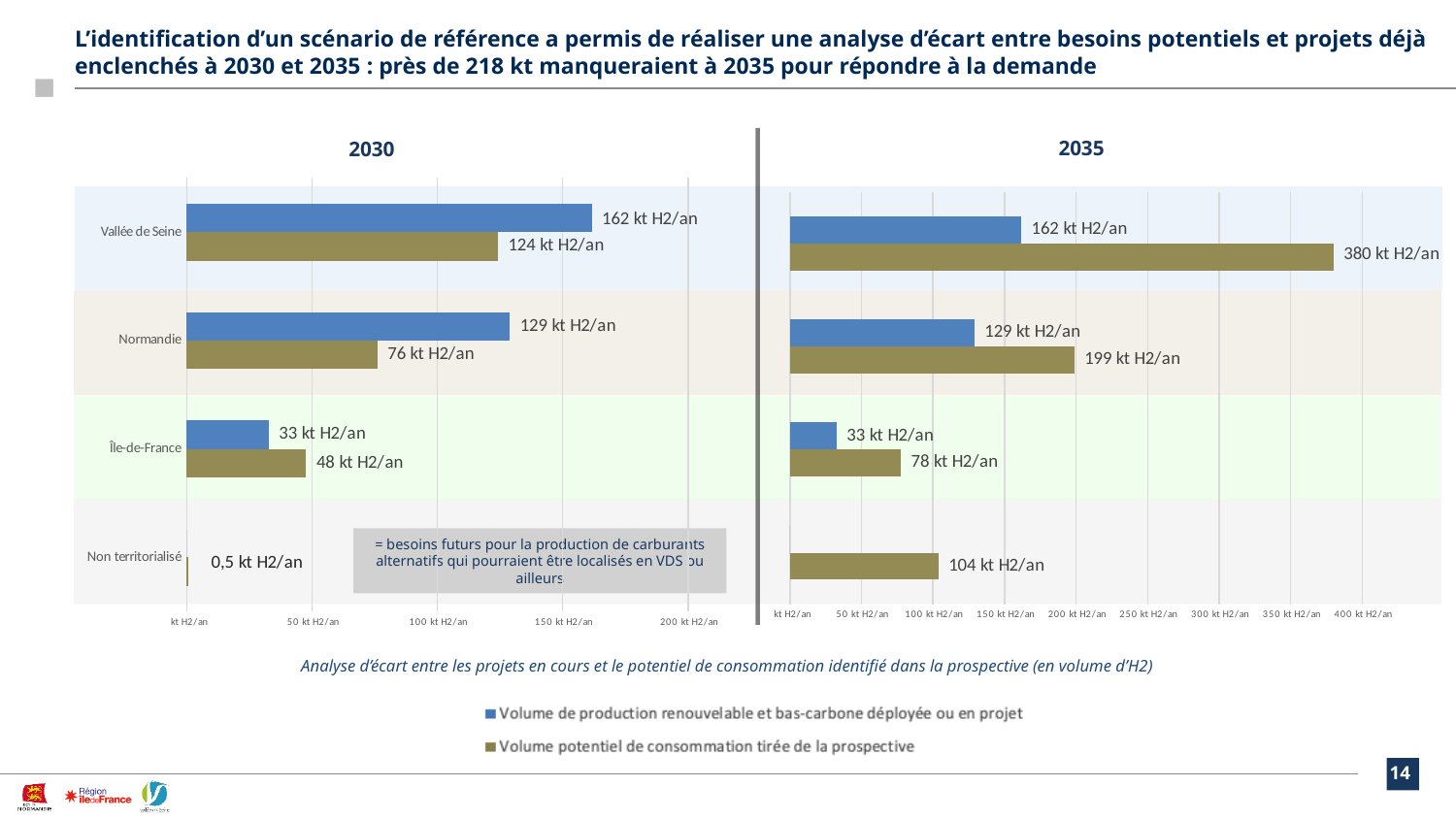
In the 2030 chart, which is larger for Île-de-France: the production volume or the potential consumption volume? Volume potentiel de consommation tirée de la prospective In the 2035 chart, what is the value of 'Volume de production renouvelable et bas-carbone déployée ou en projet' for Normandie? 129 kt H2/an In the 2035 chart, is the 'Volume potentiel de consommation tirée de la prospective' for Vallée de Seine greater or less than 350 kt H2/an? greater In the 2035 chart, what is the value of 'Volume potentiel de consommation tirée de la prospective' for Vallée de Seine? 380 kt H2/an In the 2035 chart, which category has the highest 'Volume potentiel de consommation tirée de la prospective'? Vallée de Seine How many series does the legend list? 2 How many categories are shown on the y axis of the 2030 chart? 4 In the 2030 chart, what is the value shown for Non territorialisé? 0,5 kt H2/an What type of chart is the 2035 chart? Bar chart In the 2035 chart, what is the difference between the two values shown for Normandie? 70 kt H2/an In the 2030 chart, which category has the lowest 'Volume de production renouvelable et bas-carbone déployée ou en projet' among Vallée de Seine, Normandie and Île-de-France? Île-de-France In the 2030 chart, what is the value of 'Volume potentiel de consommation tirée de la prospective' for Vallée de Seine? 124 kt H2/an